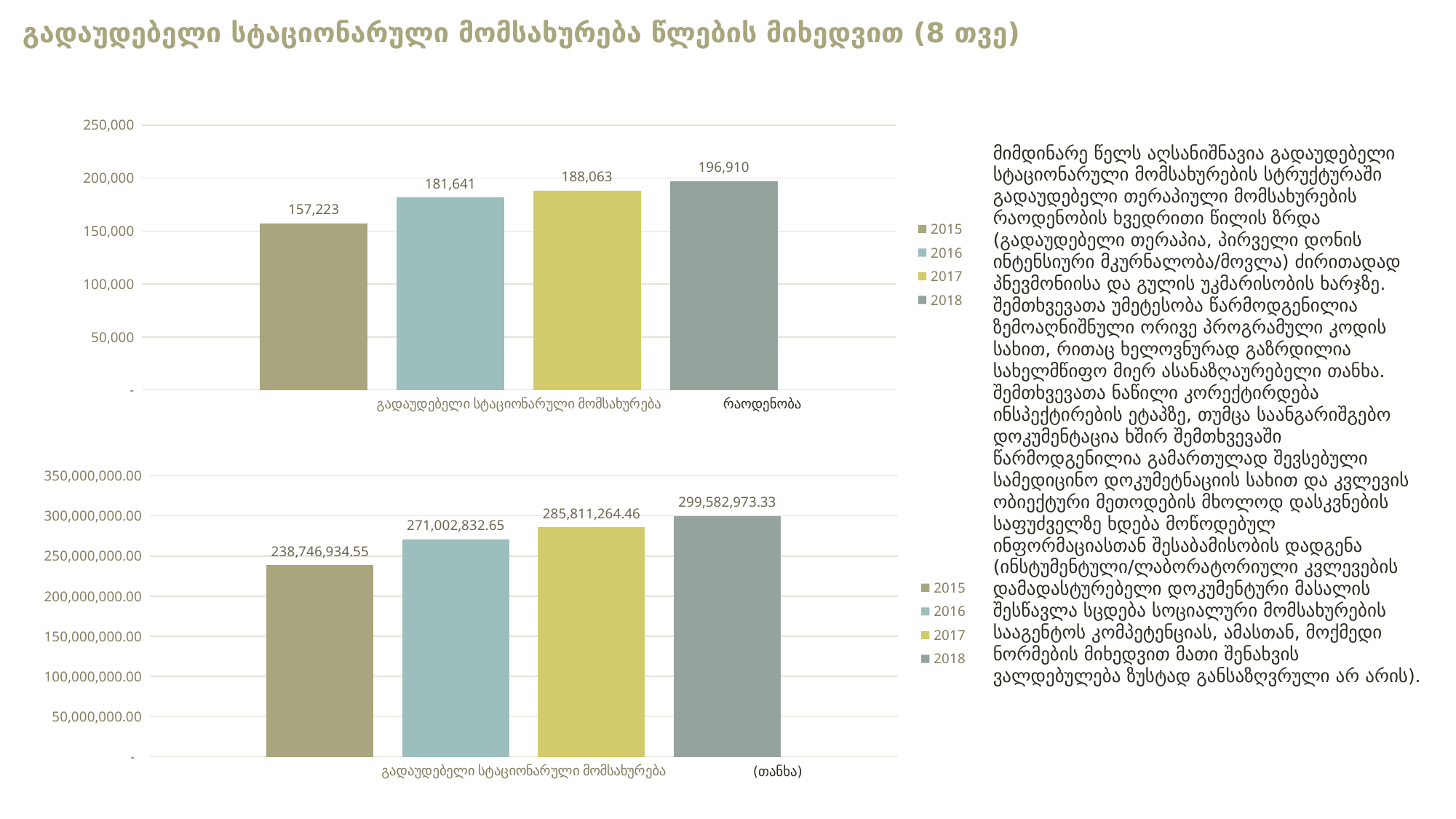
In the top chart, what is the value for 2015? 157,223 In the bottom chart, which year has the lowest value? 2015 In the top chart, what is the value for 2018? 196,910 In the top chart, which year has the highest value? 2018 In the bottom chart, what is the value for 2016? 271,002,832.65 In the top chart, which is larger, the value for 2016 or the value for 2017? 2017 In the bottom chart, what is the difference between the values for 2018 and 2017? 13,771,708.87 In the bottom chart, do the values rise or fall from 2015 to 2018? rise How many series does the legend of the bottom chart list? 4 In the bottom chart, is the value for 2015 greater or less than 250,000,000.00? less In the bottom chart, what is the value for 2018? 299,582,973.33 In the top chart, what is the difference between the values for 2018 and 2015? 39,687